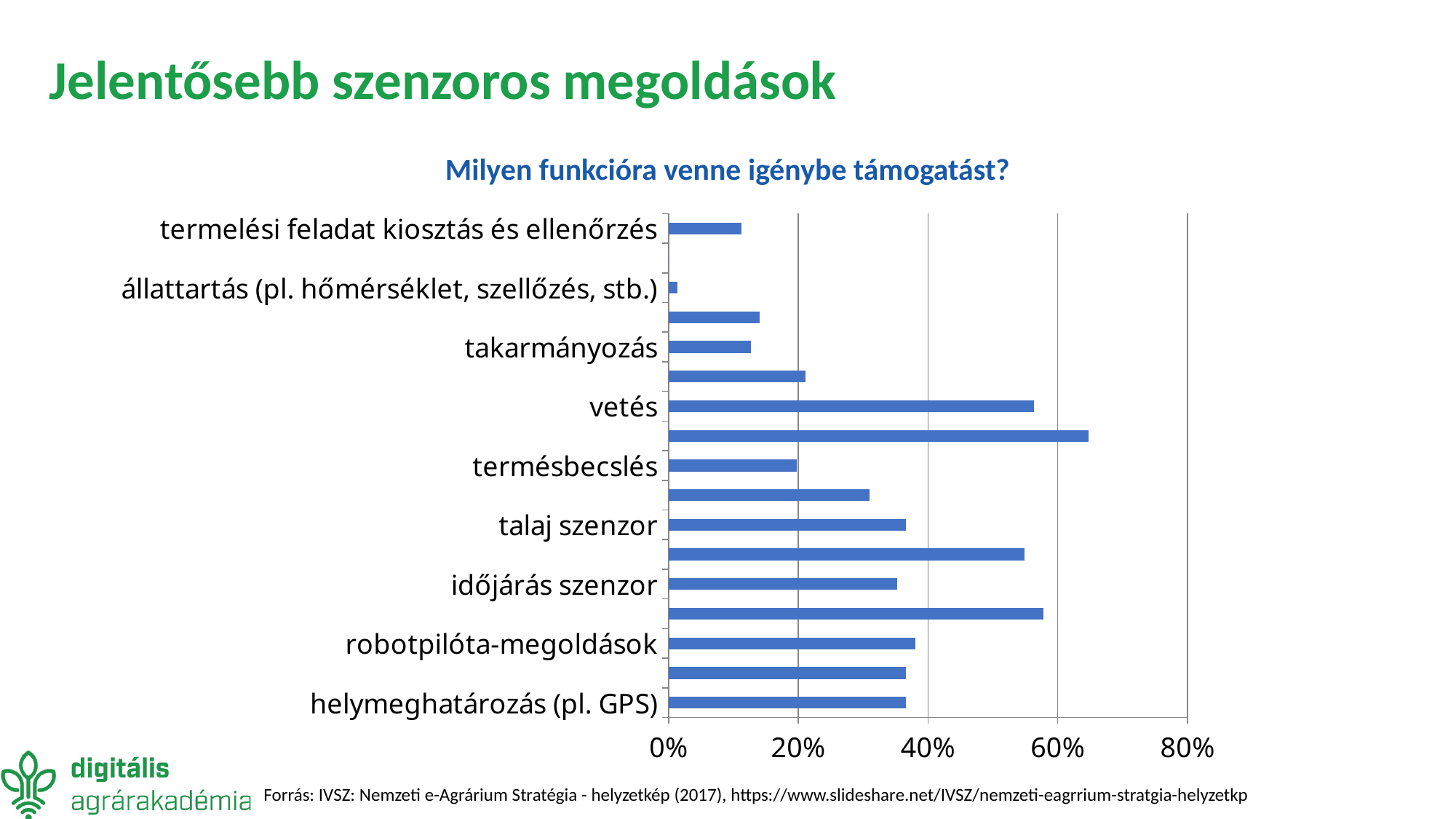
What kind of chart is shown on the slide? bar chart Is the value for állattartás (pl. hőmérséklet, szellőzés, stb.) greater or less than 20%? less Is the value for takarmányozás greater or less than 20%? less Which labelled category has the shortest bar? állattartás (pl. hőmérséklet, szellőzés, stb.) Which has the larger value, vetés or talaj szenzor? vetés Is the value for helymeghatározás (pl. GPS) greater or less than 60%? less Which has the larger value, termésbecslés or robotpilóta-megoldások? robotpilóta-megoldások What is the highest value shown on the horizontal axis? 80% What is the title of the chart? Milyen funkcióra venne igénybe támogatást?